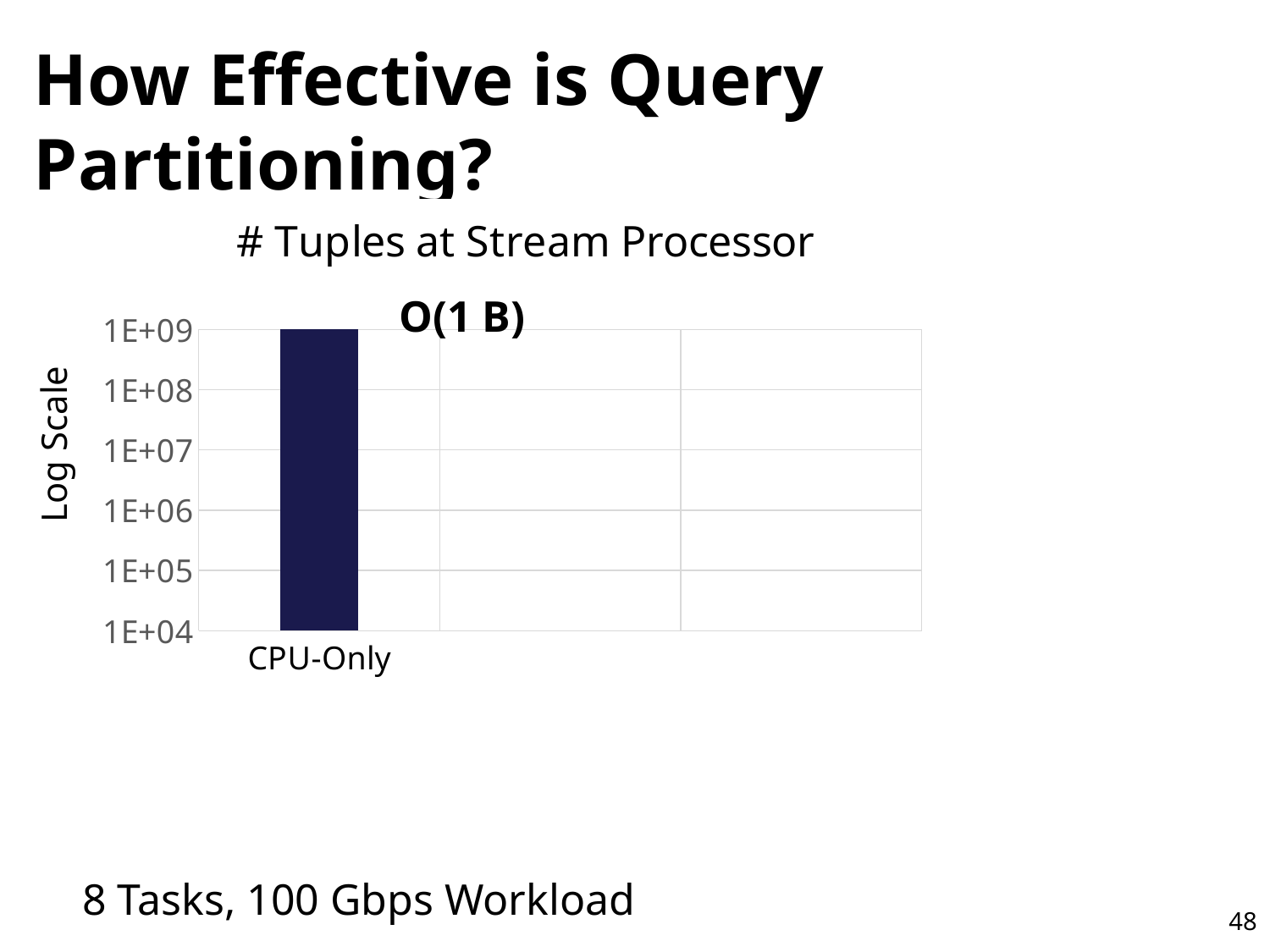
What is the highest tick value shown on the y axis? 1E+09 What is the label of the only category on the x axis? CPU-Only What value on the y axis does the CPU-Only bar reach? 1E+09 How many bars are plotted in the chart? 1 What annotation is printed above the CPU-Only bar? O(1 B) What is the title of the chart? # Tuples at Stream Processor What is the lowest tick value shown on the y axis? 1E+04 Is the value for CPU-Only greater or less than 1E+06? greater What kind of chart is shown on the slide? bar chart Is the value for CPU-Only greater or less than 1E+08? greater What is the label on the y axis of the chart? Log Scale